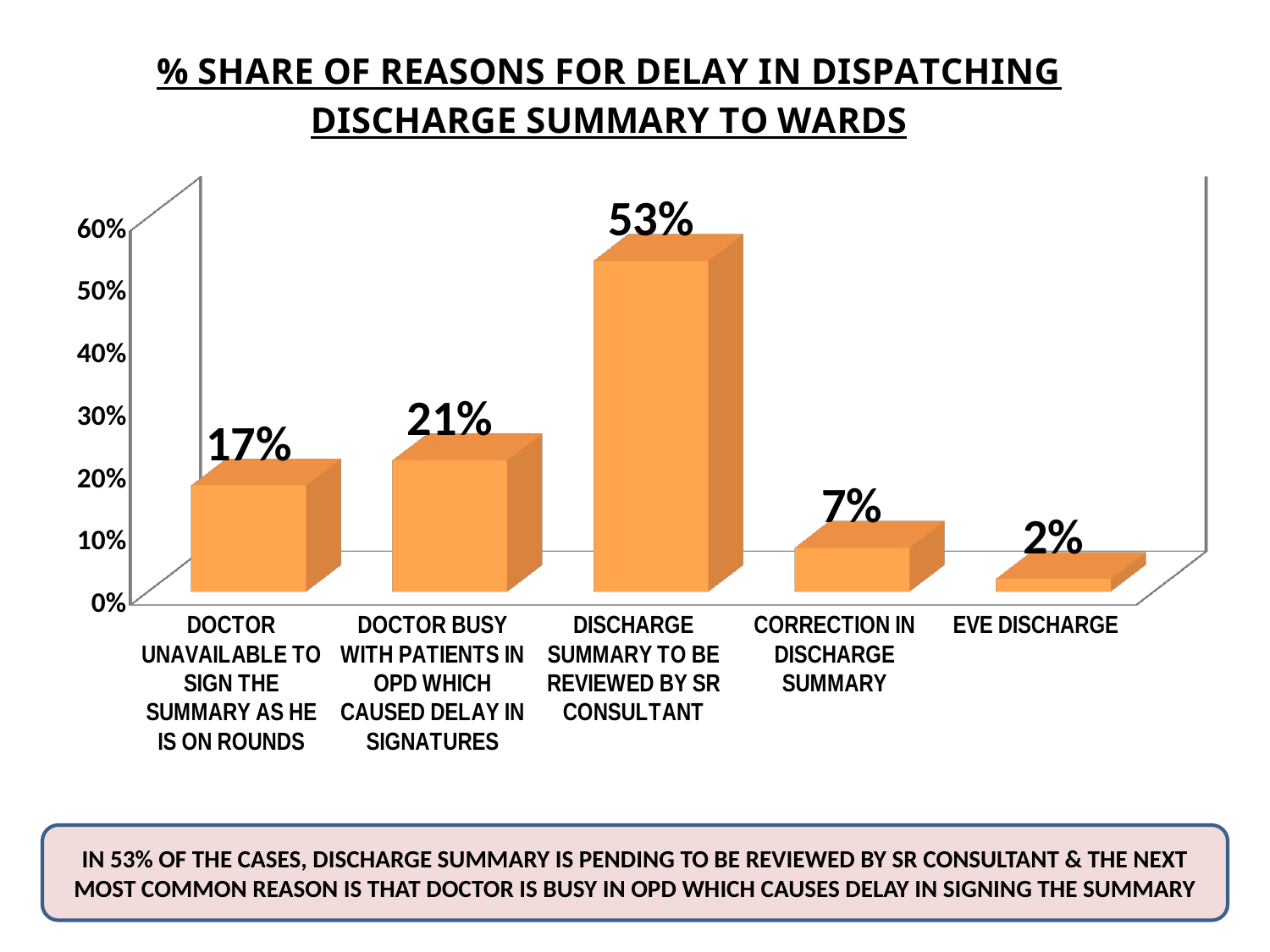
Is the value for CORRECTION IN DISCHARGE SUMMARY greater or less than 10%? less Which reason has the highest share? DISCHARGE SUMMARY TO BE REVIEWED BY SR CONSULTANT What is the difference between the values for CORRECTION IN DISCHARGE SUMMARY and EVE DISCHARGE? 5% What is the value for EVE DISCHARGE? 2% Which is larger: the value for DOCTOR BUSY WITH PATIENTS IN OPD WHICH CAUSED DELAY IN SIGNATURES or the value for DOCTOR UNAVAILABLE TO SIGN THE SUMMARY AS HE IS ON ROUNDS? DOCTOR BUSY WITH PATIENTS IN OPD WHICH CAUSED DELAY IN SIGNATURES What is the value for DOCTOR UNAVAILABLE TO SIGN THE SUMMARY AS HE IS ON ROUNDS? 17% What is the title of the chart? % SHARE OF REASONS FOR DELAY IN DISPATCHING DISCHARGE SUMMARY TO WARDS Which reason has the lowest share? EVE DISCHARGE What is the value for DISCHARGE SUMMARY TO BE REVIEWED BY SR CONSULTANT? 53% What kind of chart is shown on the slide? bar chart What is the difference between the values for DISCHARGE SUMMARY TO BE REVIEWED BY SR CONSULTANT and DOCTOR BUSY WITH PATIENTS IN OPD WHICH CAUSED DELAY IN SIGNATURES? 32% How many reasons (categories) are shown on the chart? 5